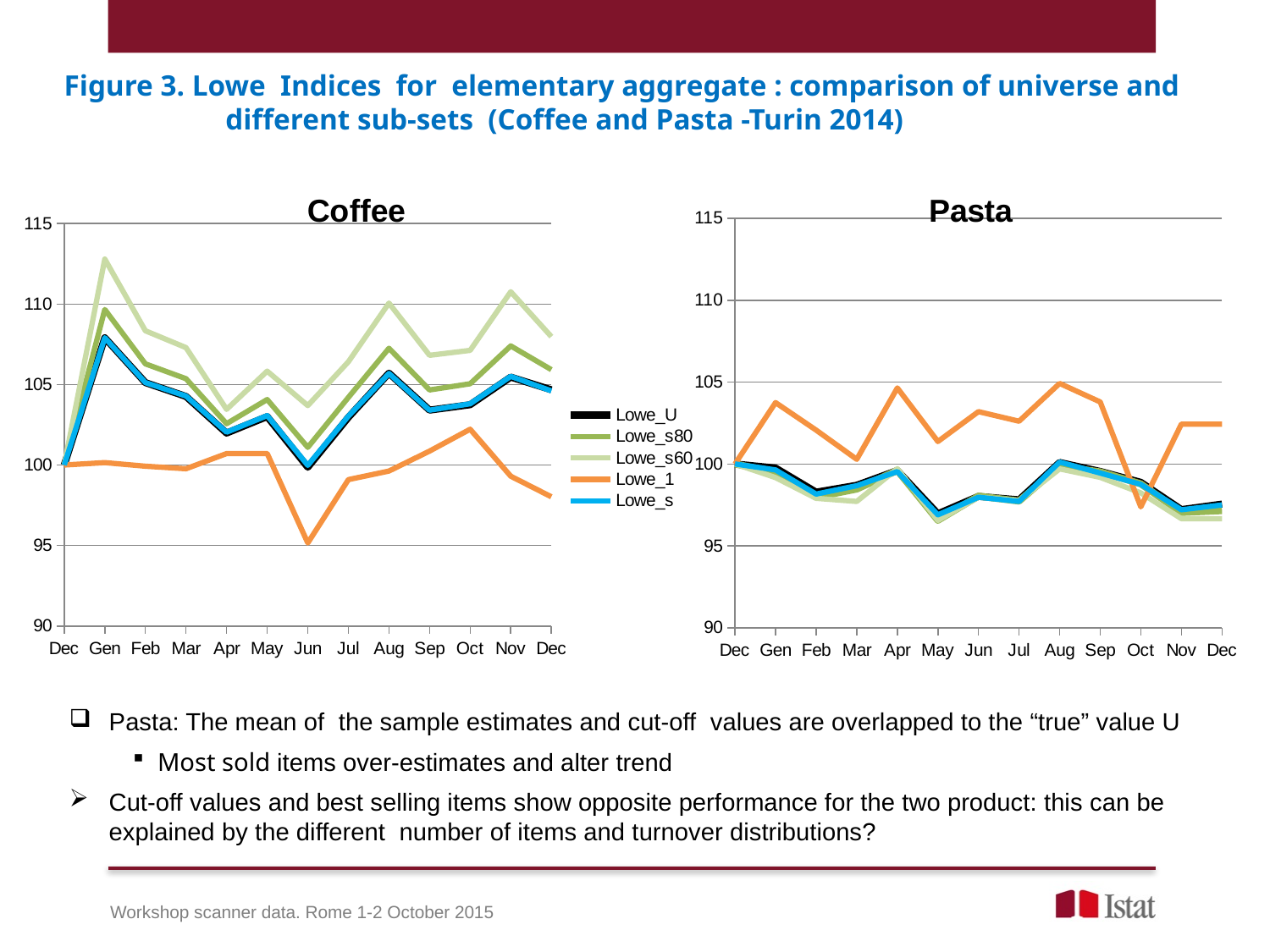
In the Pasta chart, is the value of Lowe_U in May greater or less than 100? less How many series does the legend list? 5 What are the titles of the two charts on the slide? Coffee and Pasta In the Pasta chart, is the value of Lowe_1 in Aug greater or less than 100? greater In the Coffee chart, which series reaches the highest value in Gen? Lowe_s60 In the Coffee chart, which series has the lowest value in Jun? Lowe_1 In the Coffee chart, is the value of Lowe_s60 in Gen greater or less than 110? greater How many months are plotted along the x axis of the Pasta chart? 13 What kind of chart is the Coffee chart? line chart In the Pasta chart, which series has the highest value in Apr? Lowe_1 In the Pasta chart, does Lowe_1 rise or fall from Sep to Oct? fall